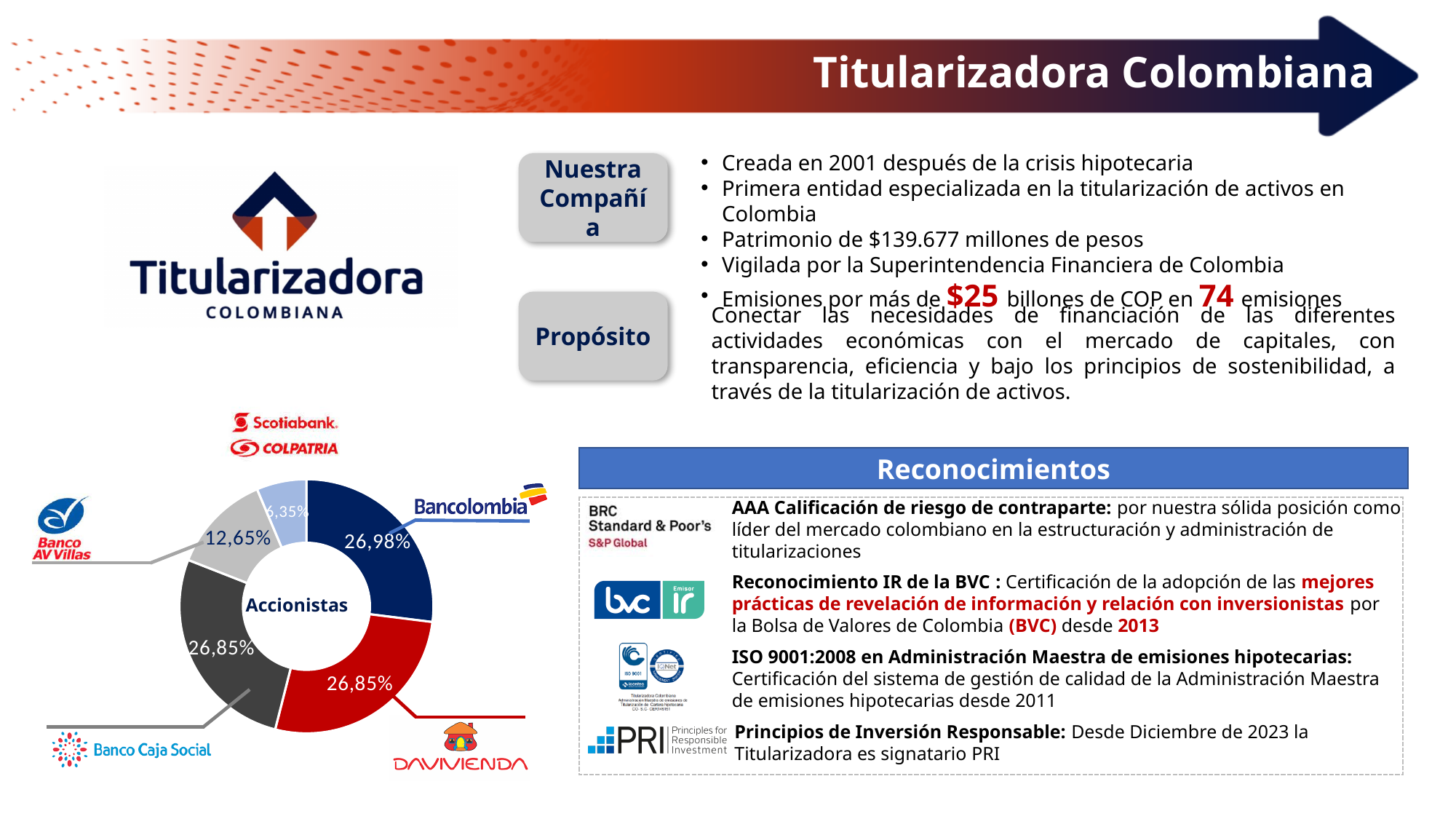
What is the value shown for Banco AV Villas in the 'Accionistas' chart? 12,65% What is the value shown for Davivienda in the 'Accionistas' chart? 26,85% In the 'Accionistas' chart, what is the combined share of Bancolombia and Davivienda? 53,83% What is the title shown in the centre of the pie chart? Accionistas In the 'Accionistas' chart, what is the difference between the shares of Banco AV Villas and Scotiabank Colpatria? 6,30% What is the value shown for Scotiabank Colpatria in the 'Accionistas' chart? 6,35% How many slices does the 'Accionistas' pie chart have? 5 Which shareholder has the largest slice in the 'Accionistas' chart? Bancolombia Which shareholder has the smallest slice in the 'Accionistas' chart? Scotiabank Colpatria In the 'Accionistas' chart, which is larger: the share of Banco AV Villas or the share of Scotiabank Colpatria? Banco AV Villas What share of the 'Accionistas' pie chart does Bancolombia hold? 26,98% What kind of chart is the 'Accionistas' chart on the slide? Pie chart (donut)